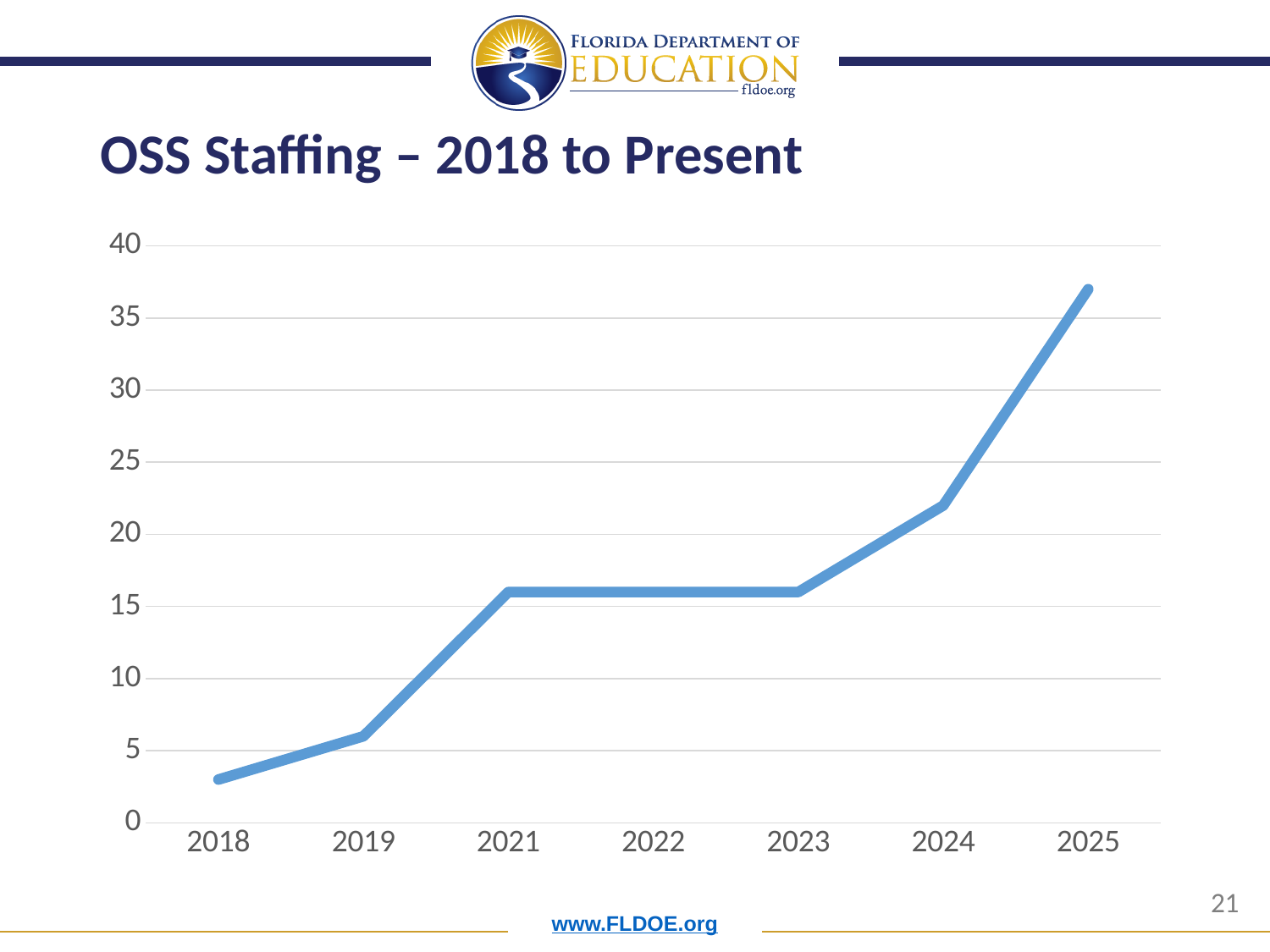
Is the value for 2023 greater or less than 20? less Is the value for 2025 greater or less than 35? greater Is the value for 2024 greater or less than 20? greater How many years are plotted on the x axis? 7 Which year has the lowest value? 2018 What kind of chart is shown on the slide? line chart What is the title of the chart? OSS Staffing – 2018 to Present Which is larger, the value for 2024 or the value for 2023? 2024 Do the values generally rise or fall from 2018 to 2025? rise Which year has the highest value? 2025